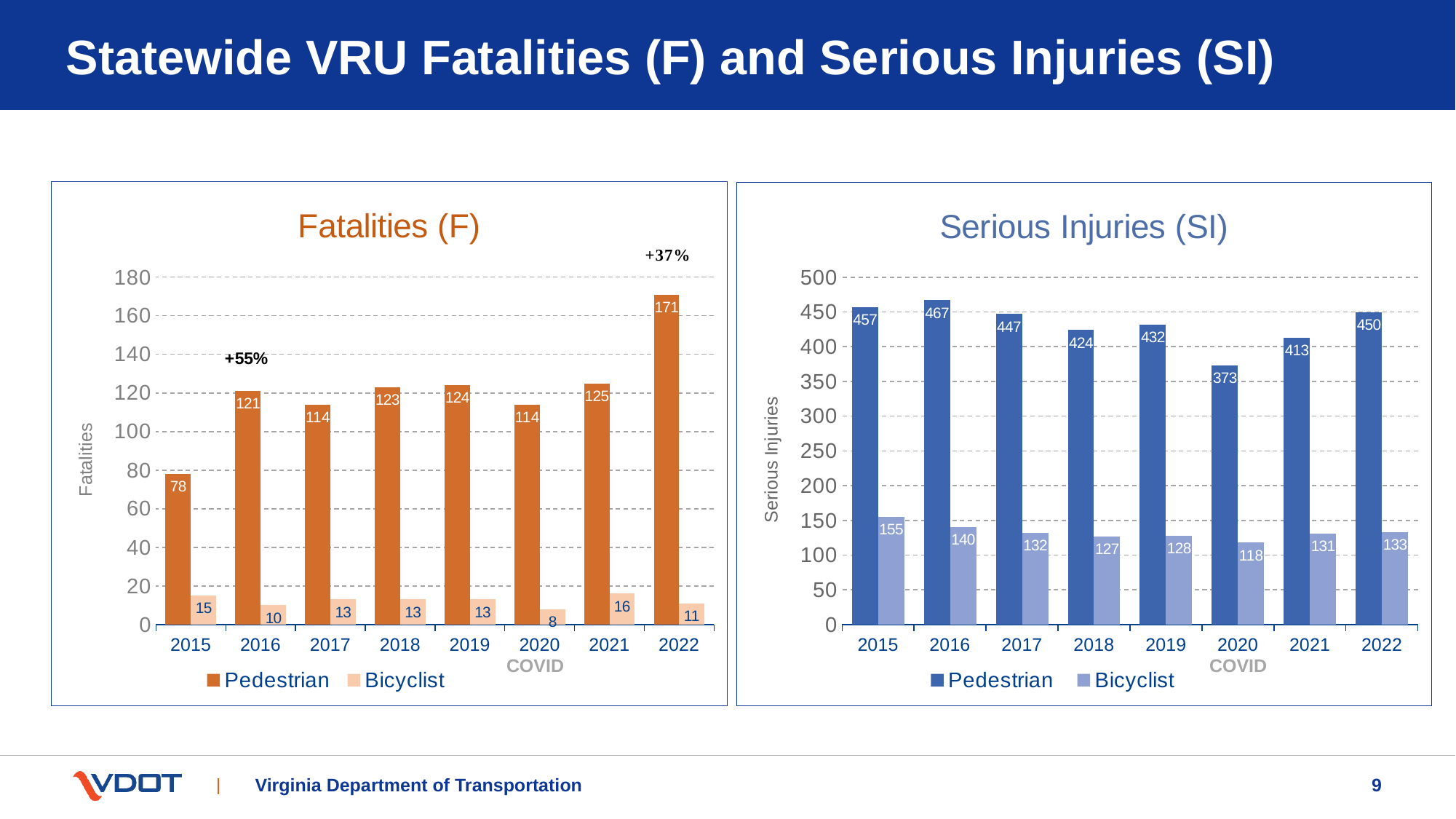
How many series does the legend of the Serious Injuries (SI) chart list? 2 In the Serious Injuries (SI) chart, is the Pedestrian value for 2020 greater or less than 400? less In the Fatalities (F) chart, what is the Bicyclist value for 2020? 8 In the Fatalities (F) chart, what is the difference between the Pedestrian values for 2022 and 2021? 46 What percentage change is annotated above the 2022 bar in the Fatalities (F) chart? +37% What kind of chart is the Serious Injuries (SI) chart? Bar chart How many years are shown on the x axis of the Fatalities (F) chart? 8 In the Fatalities (F) chart, what is the Pedestrian value for 2022? 171 In the Serious Injuries (SI) chart, which is larger: the Pedestrian value for 2016 or for 2017? 2016 In the Serious Injuries (SI) chart, which year has the lowest Pedestrian value? 2020 In the Fatalities (F) chart, which year has the highest Pedestrian value? 2022 In the Serious Injuries (SI) chart, what is the Bicyclist value for 2020? 118